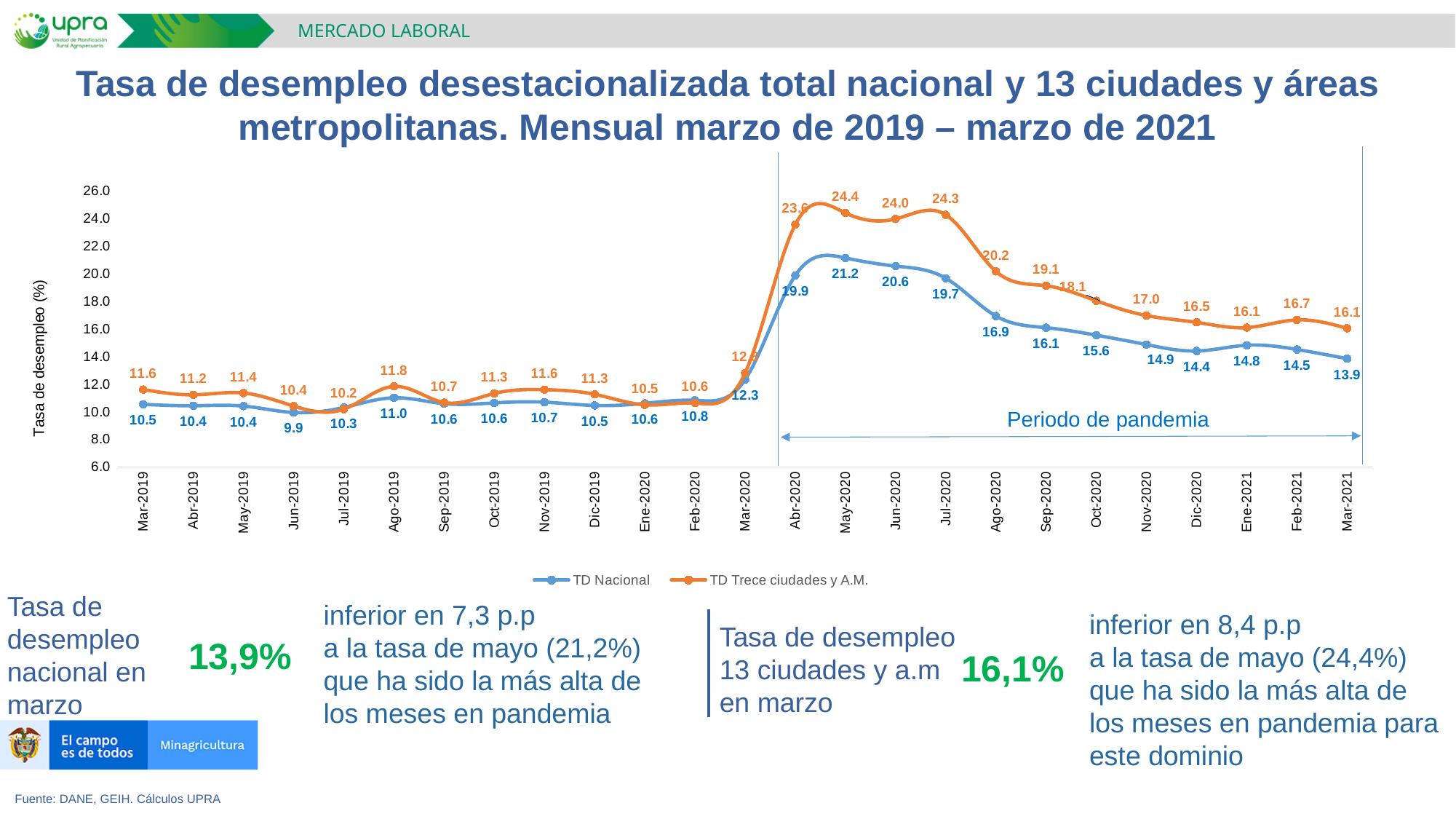
What is the value of TD Trece ciudades y A.M. in May-2020? 24.4 What is the value of TD Trece ciudades y A.M. in Mar-2021? 16.1 Does TD Nacional rise or fall from May-2020 to Mar-2021? Fall How many series does the legend list? 2 By how much did TD Nacional fall from May-2020 to Mar-2021? 7.3 How many months are plotted on the x axis? 25 What is the difference between TD Trece ciudades y A.M. and TD Nacional in Mar-2021? 2.2 In Ago-2019, which series has the higher value, TD Nacional or TD Trece ciudades y A.M.? TD Trece ciudades y A.M. What is the value of TD Nacional in May-2020? 21.2 In which month does TD Nacional reach its highest value? May-2020 What kind of chart is shown on the slide? Line chart In which month does TD Nacional reach its lowest value? Jun-2019